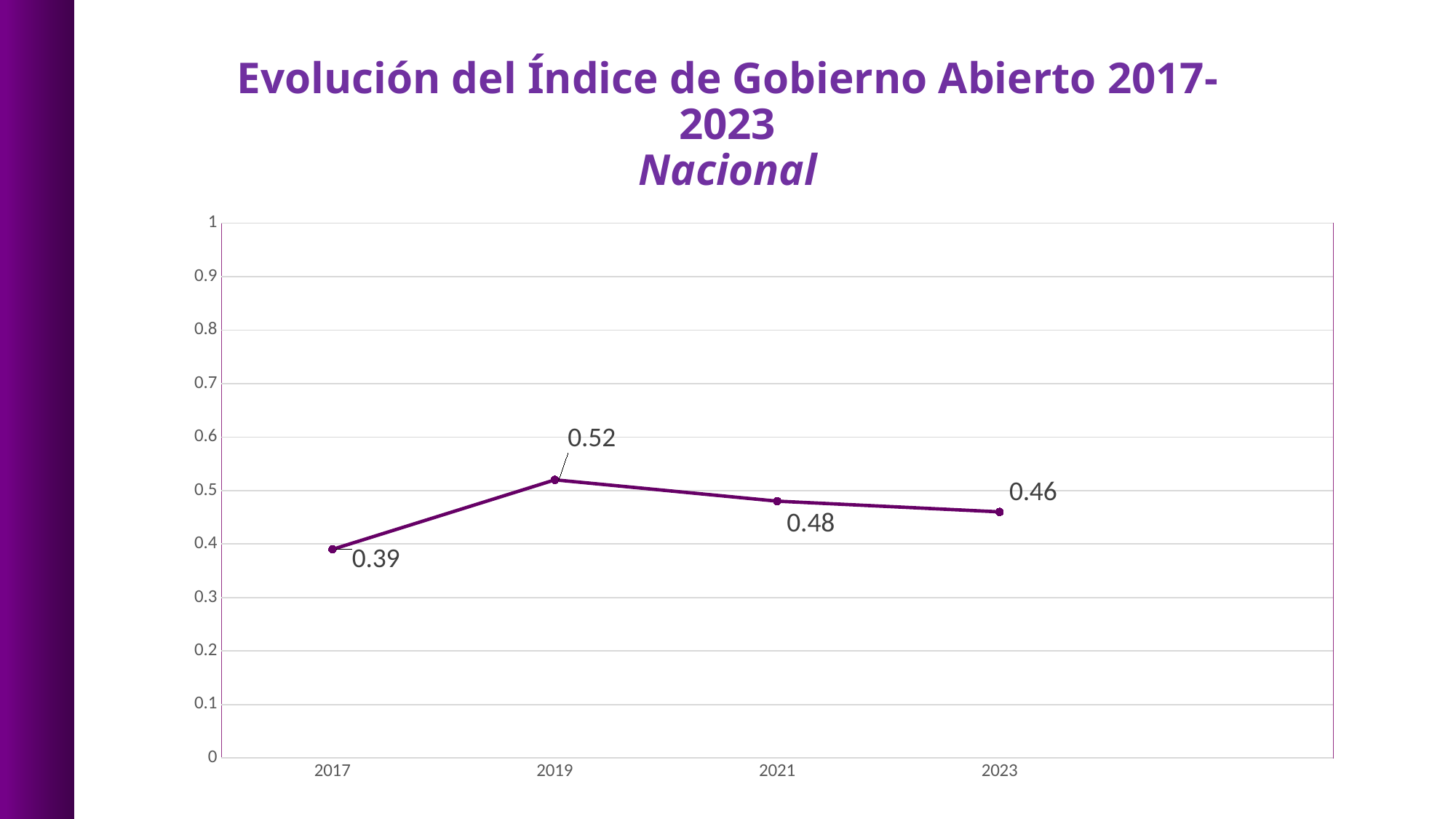
What is the value of the index for 2021? 0.48 What kind of chart is shown on the slide? Line chart What is the value of the index for 2019? 0.52 What is the difference between the index values for 2021 and 2023? 0.02 What is the value of the index for 2023? 0.46 Which year has a larger index value, 2021 or 2023? 2021 What is the difference between the index values for 2019 and 2017? 0.13 Does the index rise or fall from 2019 to 2023? Fall What is the value of the index for 2017? 0.39 Which year has the highest index value? 2019 Which year has the lowest index value? 2017 How many years are plotted on the chart? 4